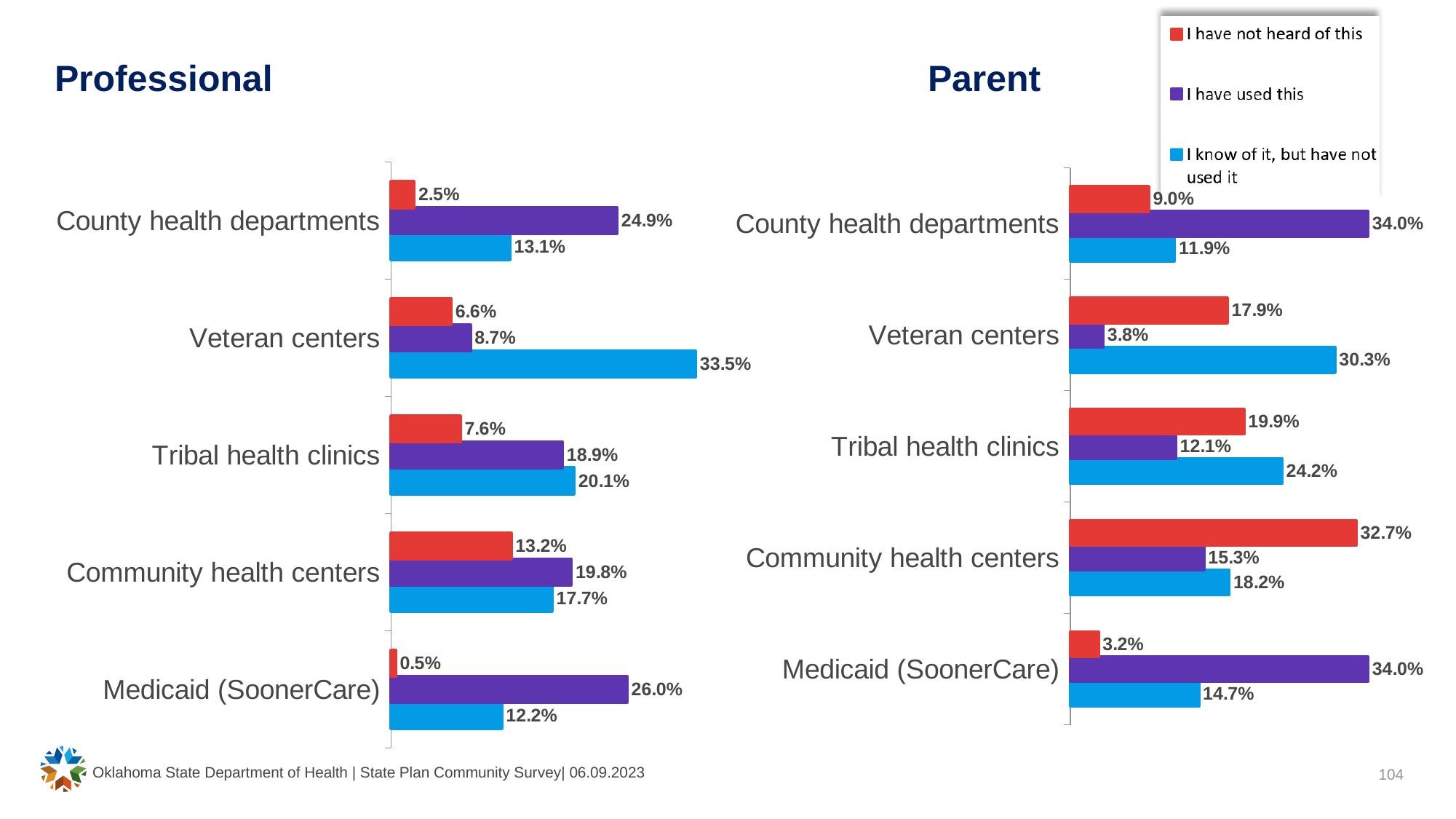
Which colour represents 'I have used this' in the legend? Purple How many series does the legend list? 3 What type of chart is the Professional chart? Bar chart In the Professional chart, which category has the lowest value for 'I have not heard of this'? Medicaid (SoonerCare) In the Parent chart, what percentage of respondents said 'I have not heard of this' for Community health centers? 32.7% In the Professional chart, what percentage of respondents said 'I have used this' for County health departments? 24.9% How many categories are shown in the Parent chart? 5 In the Professional chart, what is the value for 'I know of it, but have not used it' for Veteran centers? 33.5% In the Parent chart, what is the difference between the 'I have used this' value for Medicaid (SoonerCare) and the 'I have used this' value for Veteran centers? 30.2% In the Professional chart, which is larger for Tribal health clinics: 'I have used this' or 'I know of it, but have not used it'? I know of it, but have not used it In the Parent chart, which category has the highest value for 'I have not heard of this'? Community health centers In the Professional chart, what is the difference between the 'I have not heard of this' values for Community health centers and County health departments? 10.7%